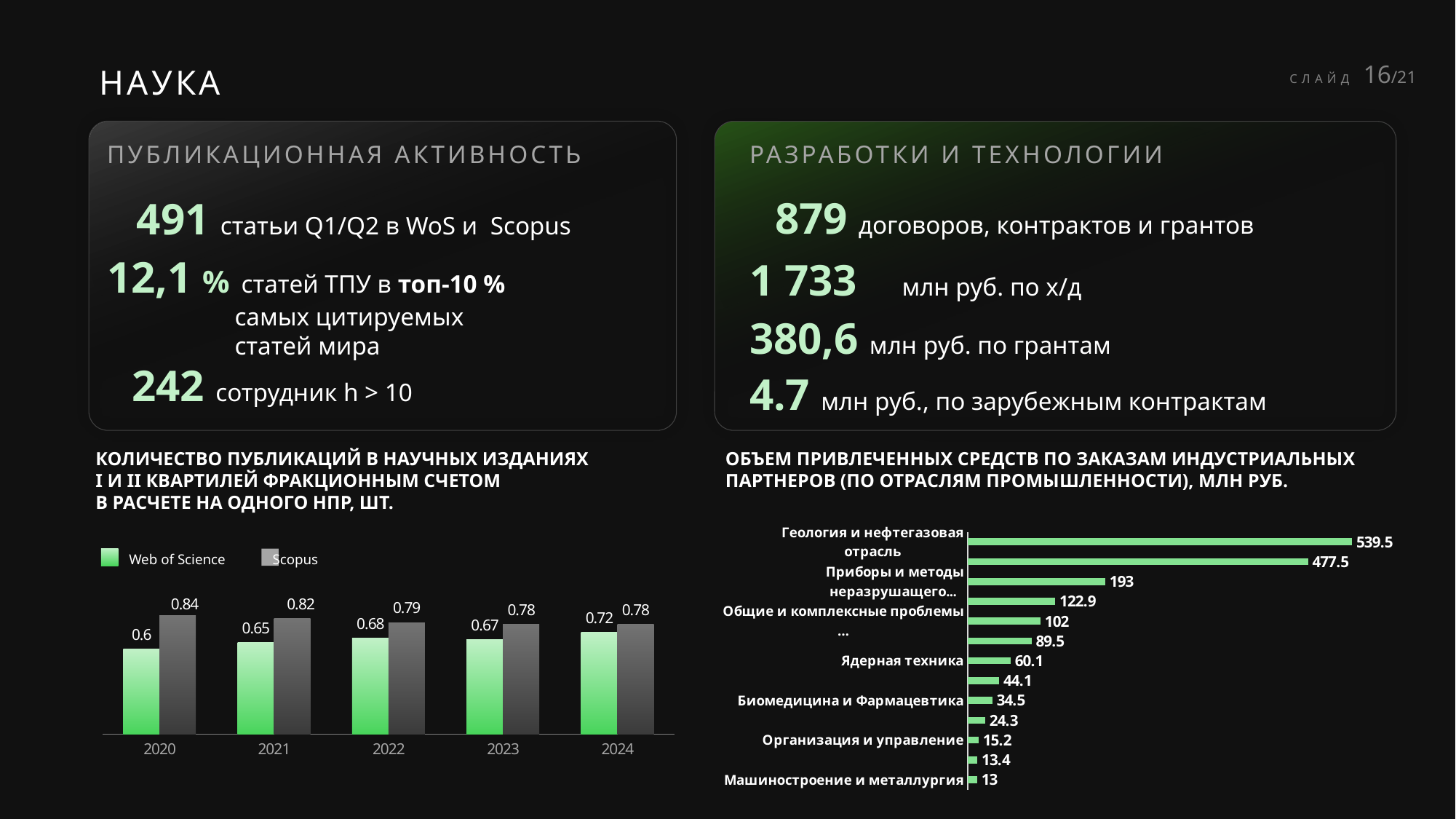
On the left chart (publications per NPR), which year has the highest Web of Science value? 2024 On the right chart (funds attracted by industry), what is the value for Геология и нефтегазовая отрасль? 539.5 What type of chart is the left chart (publications per NPR)? bar chart On the left chart (publications per NPR), what is the difference between the Scopus and Web of Science values in 2021? 0.17 On the right chart (funds attracted by industry), how many bars are plotted? 13 On the right chart (funds attracted by industry), which category has the lowest value? Машиностроение и металлургия On the right chart (funds attracted by industry), what is the value for Ядерная техника? 60.1 On the left chart (publications per NPR), what is the Scopus value for 2022? 0.79 On the left chart (publications per NPR), what is the Web of Science value for 2020? 0.6 On the left chart (publications per NPR), how many series does the legend list? 2 On the left chart (publications per NPR), which year has the lowest Scopus value? 2023 and 2024 (both 0.78) On the left chart (publications per NPR), do the Web of Science values generally rise or fall from 2020 to 2024? rise